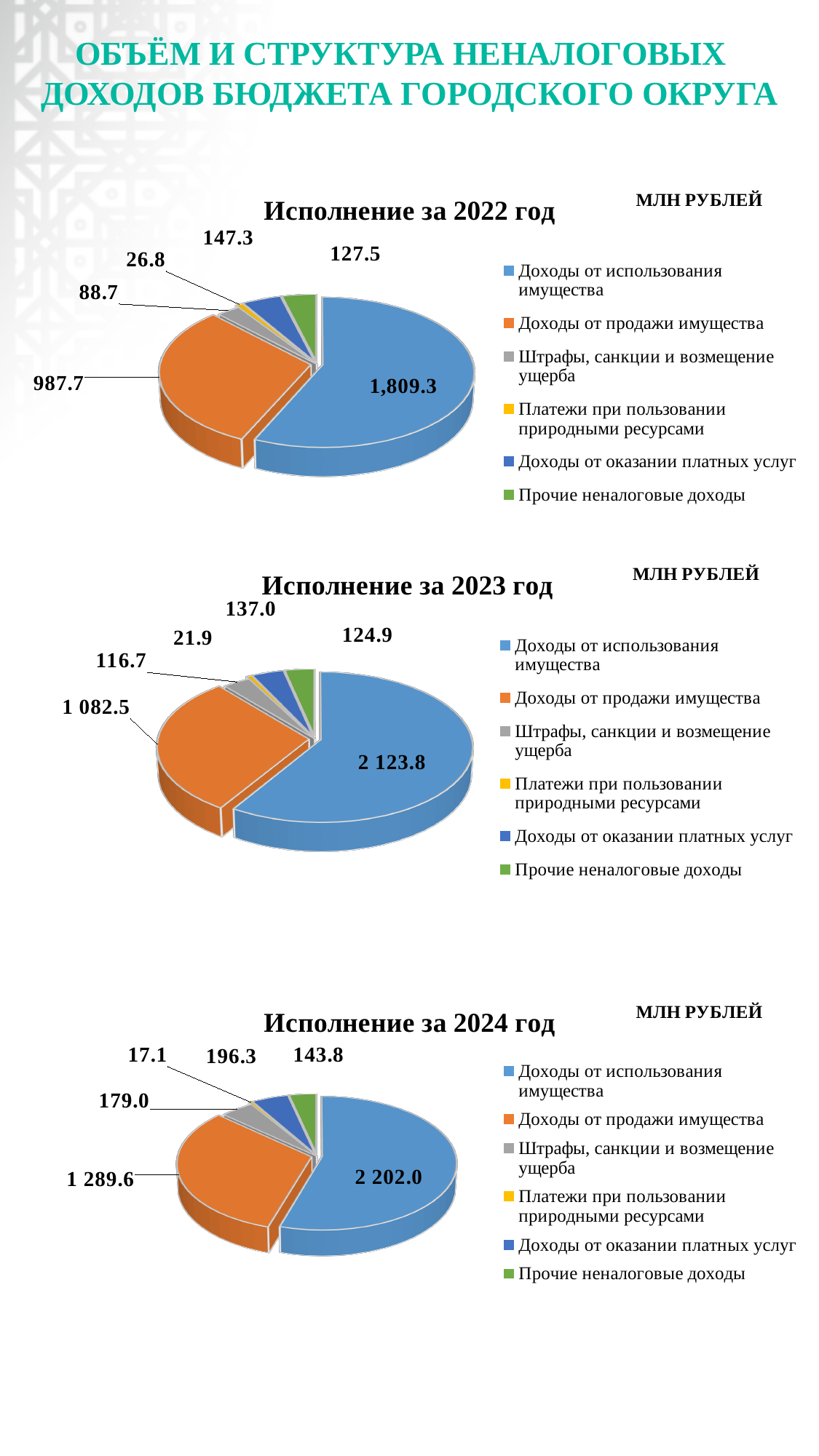
What unit is stated next to the chart 'Исполнение за 2022 год'? МЛН РУБЛЕЙ In the chart 'Исполнение за 2023 год', what is the value for Доходы от продажи имущества? 1 082.5 In the chart 'Исполнение за 2024 год', what is the value for Доходы от оказании платных услуг? 196.3 How many categories does the chart 'Исполнение за 2022 год' show? 6 In the chart 'Исполнение за 2024 год', which category has the largest value? Доходы от использования имущества In the chart 'Исполнение за 2023 год', which is larger: Штрафы, санкции и возмещение ущерба or Платежи при пользовании природными ресурсами? Штрафы, санкции и возмещение ущерба In the chart 'Исполнение за 2024 год', what is the difference between Доходы от использования имущества and Доходы от продажи имущества? 912.4 What kind of chart is 'Исполнение за 2023 год'? Pie chart In the chart 'Исполнение за 2024 год', what is the value for Штрафы, санкции и возмещение ущерба? 179.0 In the chart 'Исполнение за 2022 год', what is the value for Доходы от использования имущества? 1,809.3 In the chart 'Исполнение за 2023 год', what is the value for Платежи при пользовании природными ресурсами? 21.9 In the chart 'Исполнение за 2022 год', which category has the smallest value? Платежи при пользовании природными ресурсами